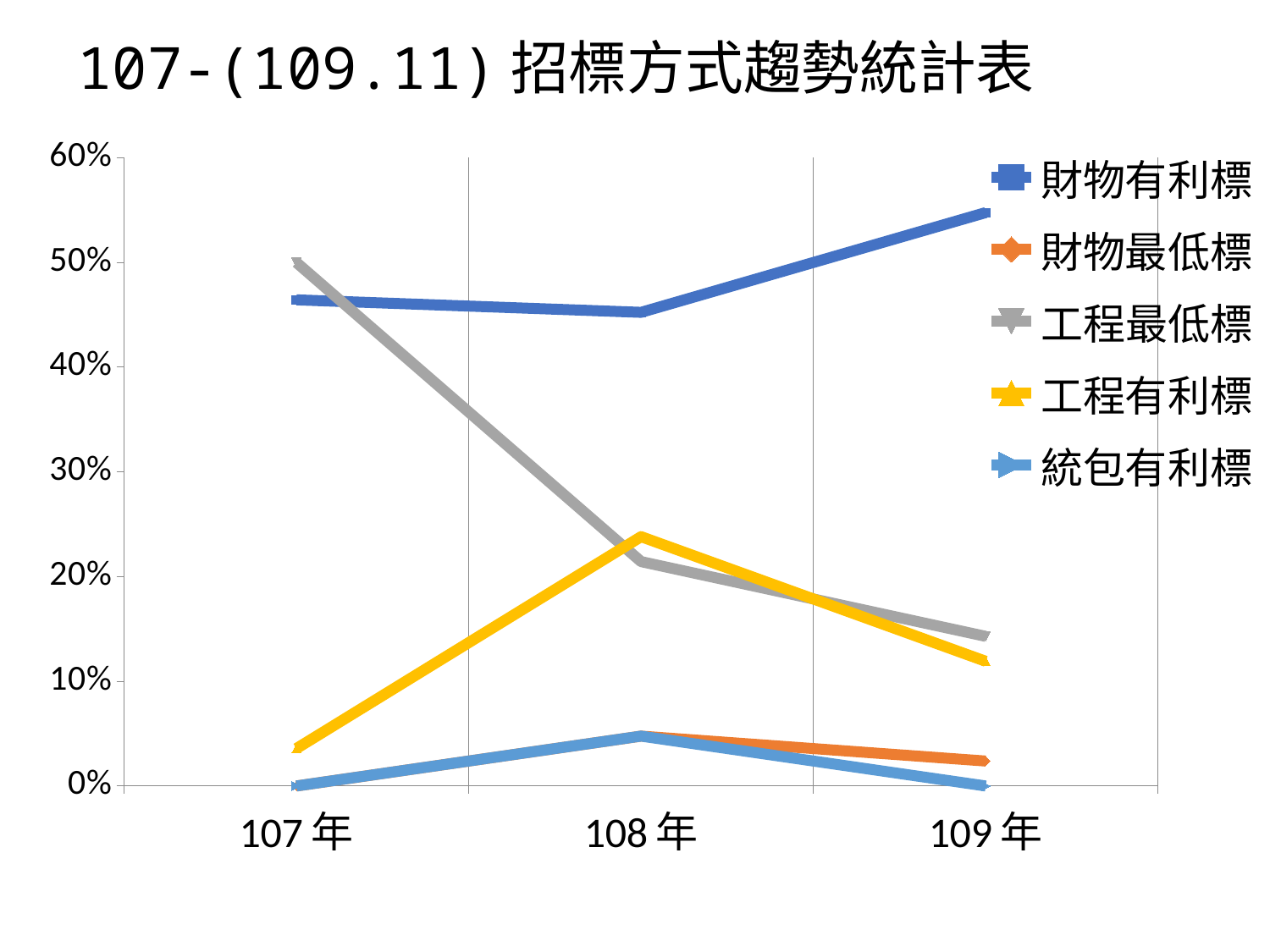
Is the value for 工程最低標 in 109年 greater or less than 20%? less How many series does the legend list? 5 How many years are shown on the x axis? 3 What kind of chart is shown on the slide? line chart Does the 財物有利標 line rise or fall from 108年 to 109年? rise Is the value for 工程最低標 in 107年 greater or less than 40%? greater What is the title of the chart? 107-(109.11)招標方式趨勢統計表 Is the value for 財物有利標 in 109年 greater or less than 50%? greater Does the 工程最低標 line rise or fall from 107年 to 109年? fall In 107年, which is larger: 工程最低標 or 工程有利標? 工程最低標 Which series has the highest value in 109年? 財物有利標